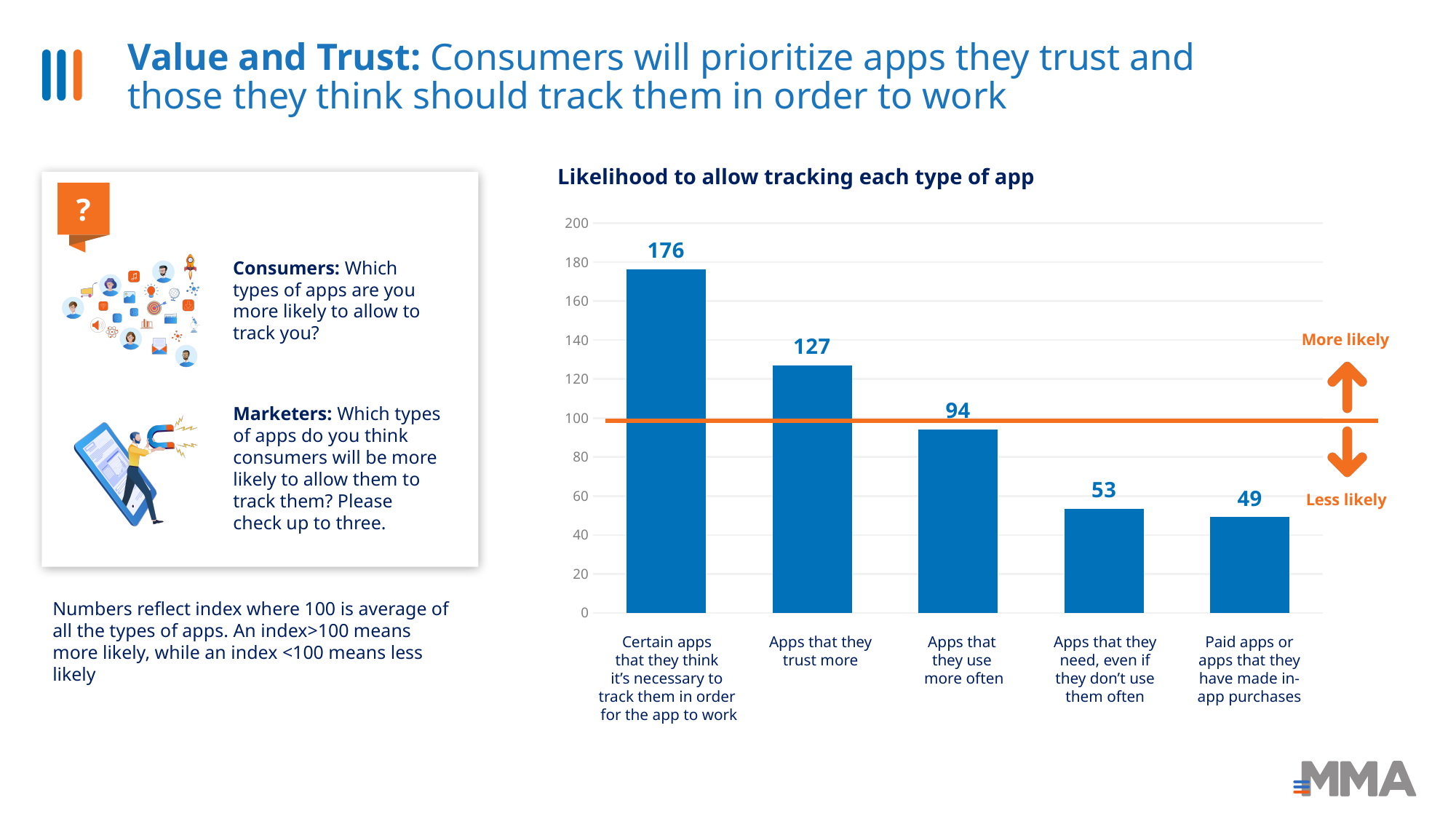
Which type of app has the lowest likelihood index? Paid apps or apps that they have made in-app purchases Which has a higher index: apps that they trust more or apps that they use more often? Apps that they trust more What is the likelihood index for apps that they trust more? 127 Which type of app has the highest likelihood index? Certain apps that they think it's necessary to track them in order for the app to work What kind of chart is used to show the likelihood to allow tracking each type of app? Bar chart What is the likelihood index for apps that they use more often? 94 How many types of app are shown in the chart? 5 What is the title of the chart? Likelihood to allow tracking each type of app Is the value for apps that they use more often greater or less than 100? less What is the difference between the index for certain apps that they think it's necessary to track them in order for the app to work and the index for apps that they trust more? 49 What is the difference between the index for apps that they need, even if they don't use them often and the index for paid apps or apps that they have made in-app purchases? 4 What is the likelihood index for paid apps or apps that they have made in-app purchases? 49